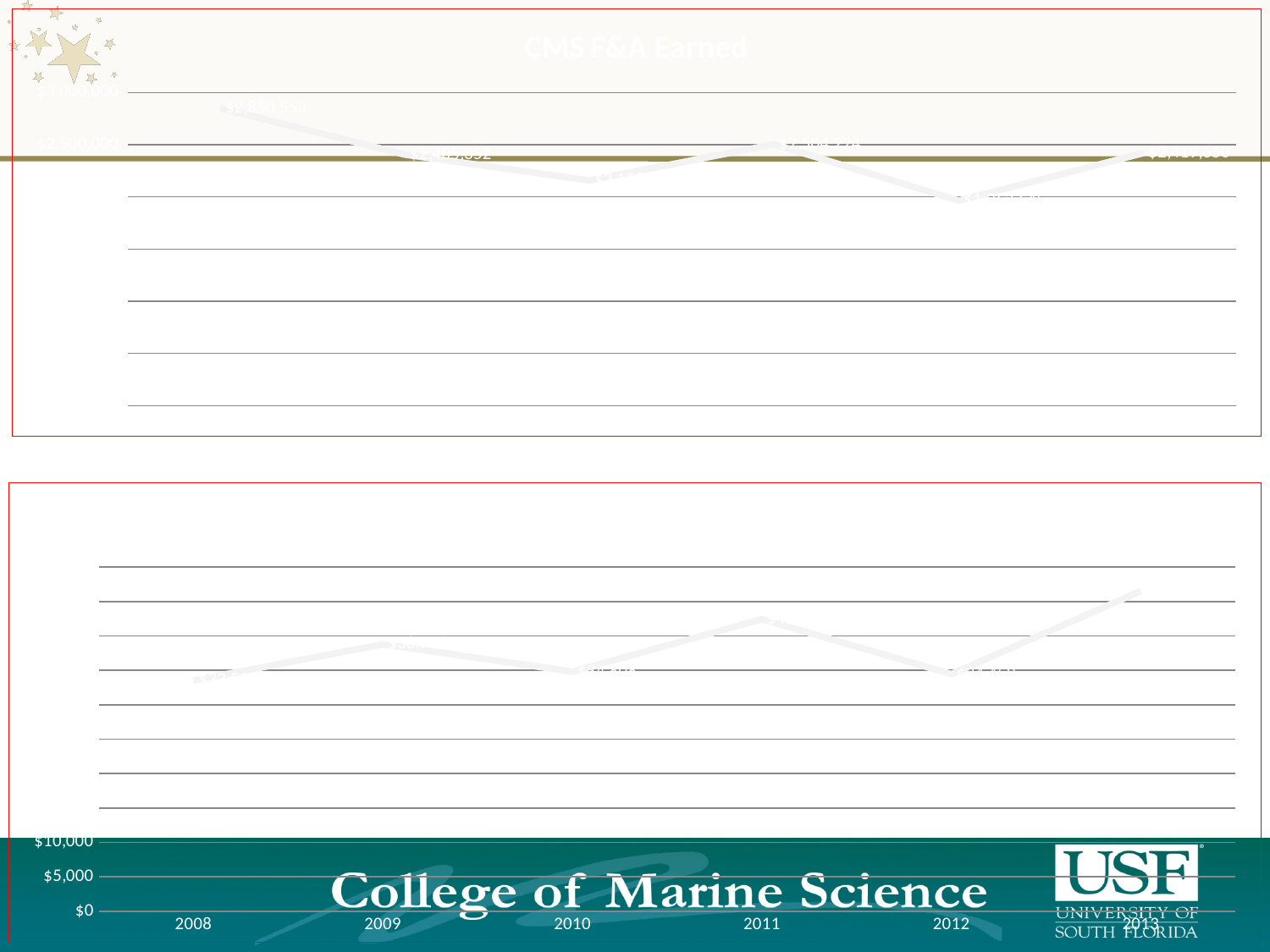
In the bottom chart, does the line rise or fall from 2012 to 2013? rise What kind of chart is the top chart, CMS F&A Earned? line chart In the bottom chart, which is larger, the value for 2011 or the value for 2010? 2011 What kind of chart is the bottom chart? line chart In the bottom chart, is the value for 2013 greater or less than $10,000? greater In the top chart, CMS F&A Earned, is the leftmost data point greater or less than $2,500,000? greater What is the title of the top chart? CMS F&A Earned In the top chart, CMS F&A Earned, does the line rise or fall from the first point to the second point? fall In the bottom chart, which year has the highest value? 2013 In the bottom chart, how many years are shown on the x axis? 6